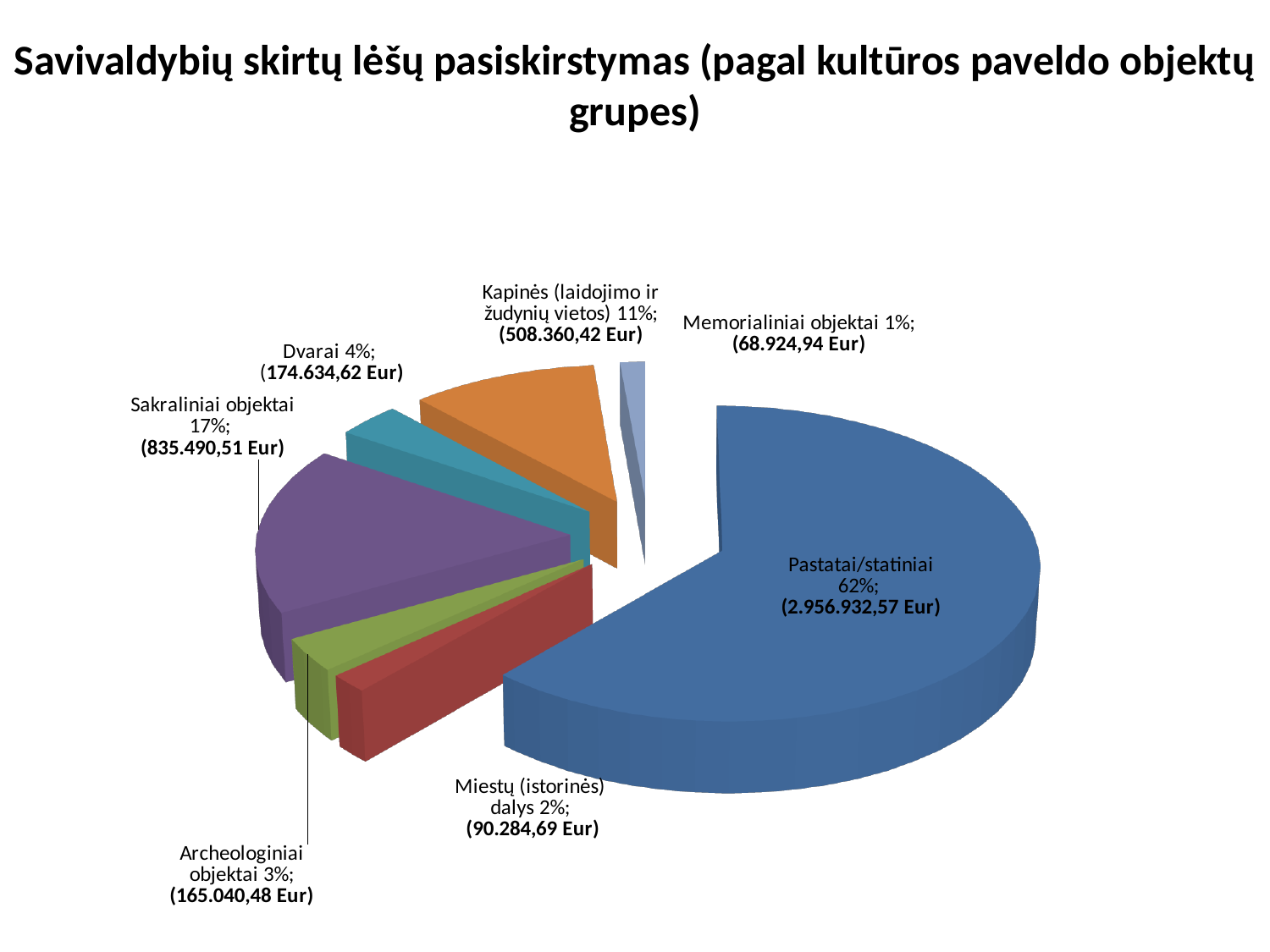
What kind of chart is shown on the slide? pie chart What amount in Eur is shown for Kapinės (laidojimo ir žudynių vietos)? 508.360,42 Eur What percentage share of the pie does Pastatai/statiniai have? 62% How many slices does the pie chart have? 7 Which category received the largest share of municipal funds? Pastatai/statiniai What percentage share of the pie does Dvarai have? 4% What amount in Eur is shown for Sakraliniai objektai? 835.490,51 Eur What is the difference in Eur between Dvarai and Archeologiniai objektai? 9.594,14 Eur Which received more funds, Dvarai or Archeologiniai objektai? Dvarai Which category received the smallest share of municipal funds? Memorialiniai objektai What is the title of the chart on the slide? Savivaldybių skirtų lėšų pasiskirstymas (pagal kultūros paveldo objektų grupes) What amount in Eur is shown for Miestų (istorinės) dalys? 90.284,69 Eur